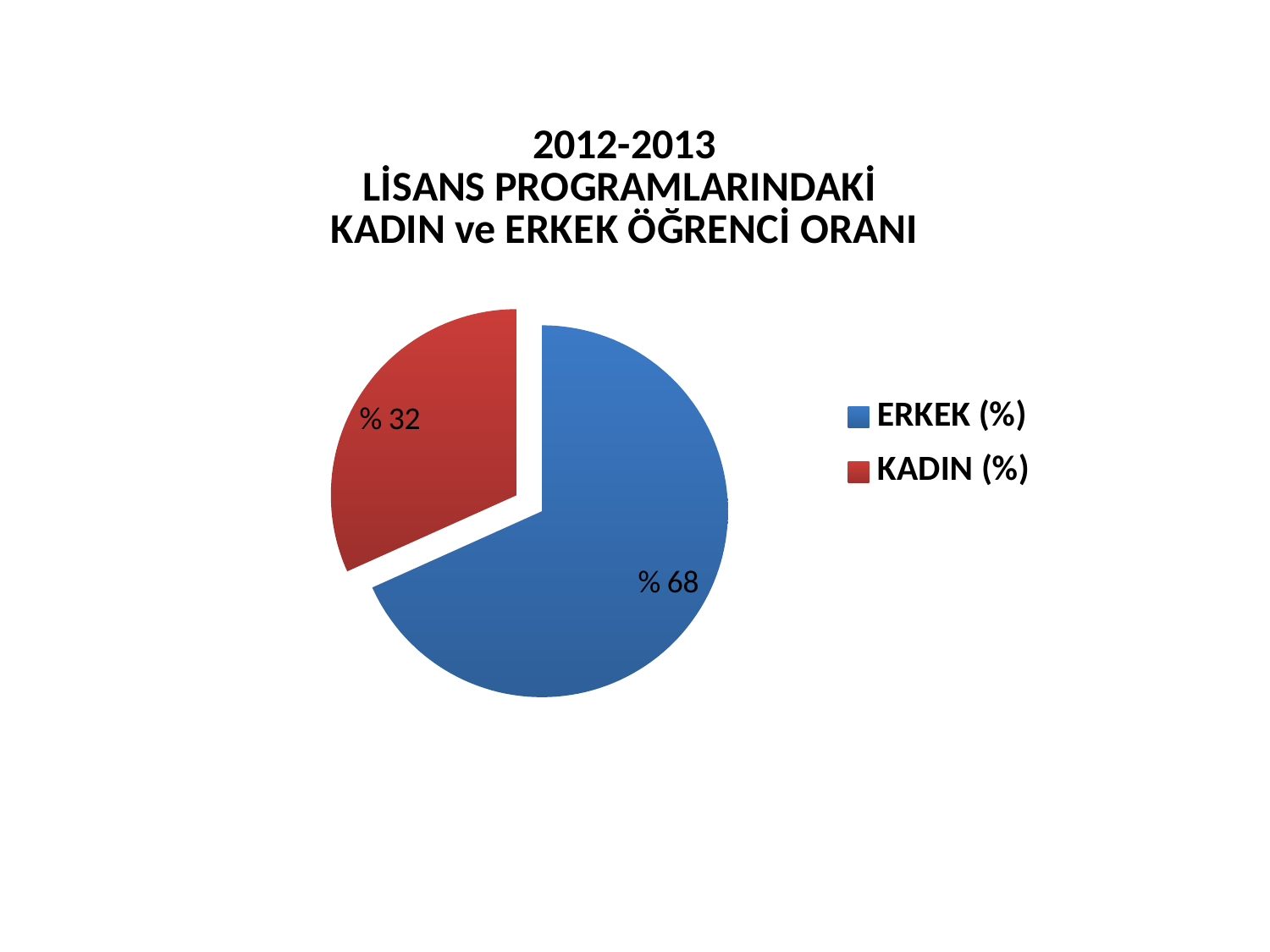
How many entries does the legend list? 2 Which slice is the largest? ERKEK (%) What is the value shown for ERKEK (%)? % 68 Which academic year does the chart title refer to? 2012-2013 What is the value shown for KADIN (%)? % 32 What colour is the ERKEK (%) slice? blue What is the difference between the ERKEK (%) and KADIN (%) values? 36 Which slice is the smallest? KADIN (%) What kind of chart is shown on the slide? pie chart What share of the pie does the KADIN (%) slice represent? % 32 How many slices does the pie chart have? 2 Which is larger, the ERKEK (%) slice or the KADIN (%) slice? ERKEK (%)